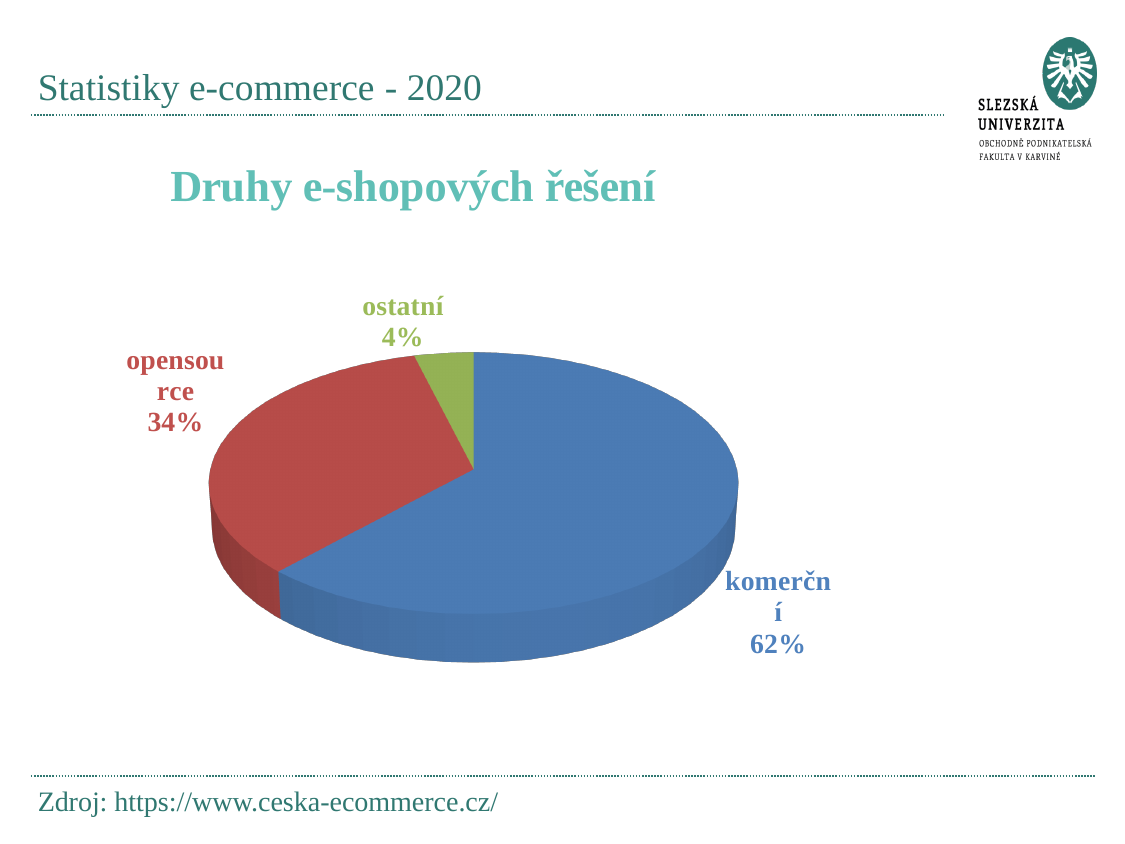
What share of the pie does the komerční slice represent? 62% What is the difference in percentage points between the opensource and ostatní slices? 30 Which category has the largest slice of the pie? komerční What kind of chart is shown on the slide? pie chart How many slices does the pie chart have? 3 What is the difference in percentage points between the komerční and opensource slices? 28 What is the title of the chart? Druhy e-shopových řešení What share of the pie does the ostatní slice represent? 4% Which is larger, the opensource slice or the ostatní slice? opensource Which category has the smallest slice of the pie? ostatní What colour is the komerční slice? blue What share of the pie does the opensource slice represent? 34%